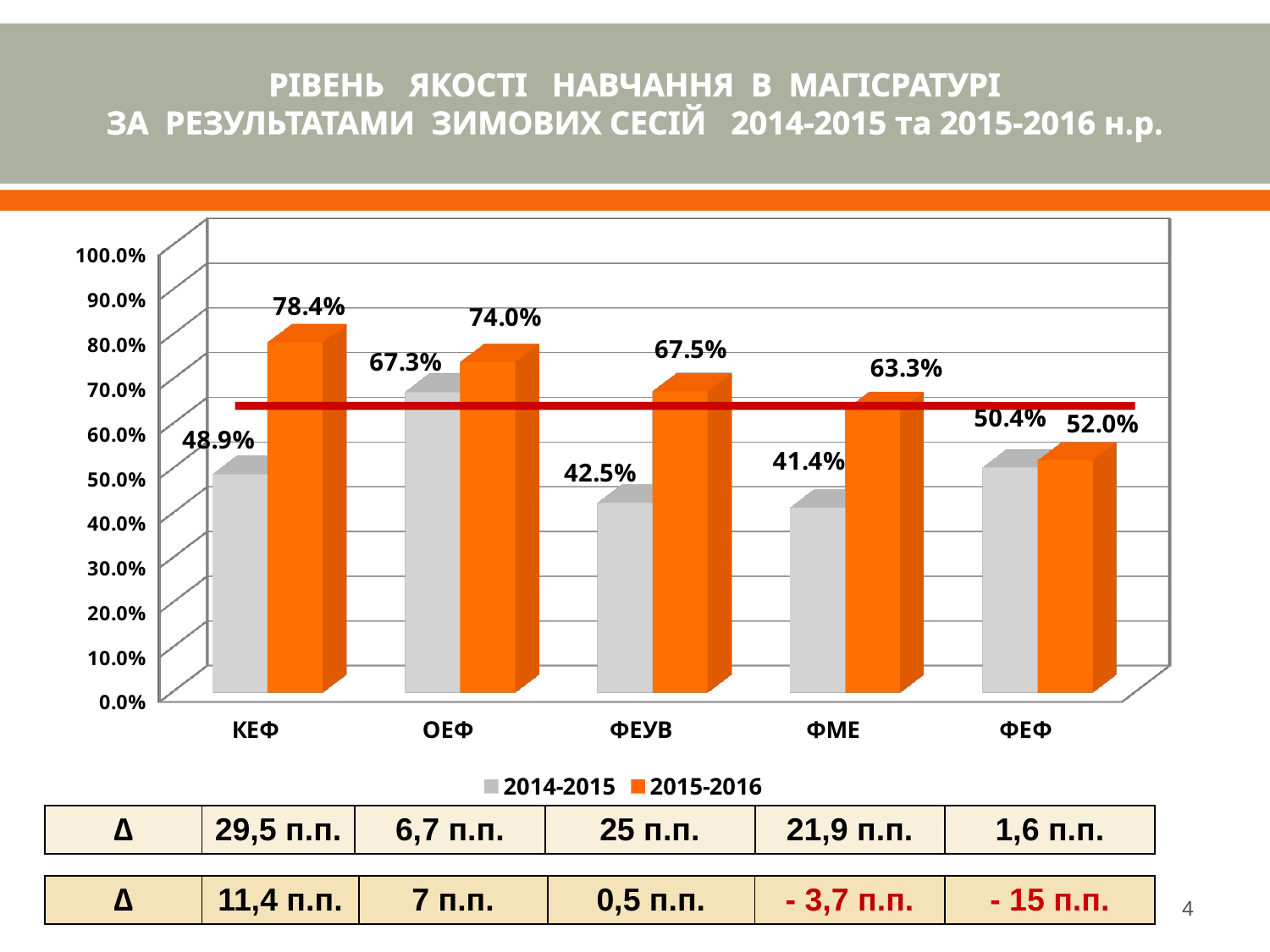
Which category has the lowest value in the 2014-2015 series? ФМЕ What is the value for ФМЕ in the 2014-2015 series? 41.4% Is the 2014-2015 value for ФЕУВ greater or less than 50.0%? less What is the value for КЕФ in the 2015-2016 series? 78.4% What kind of chart is shown on the slide? bar chart Which colour represents the 2015-2016 series in the legend? orange How many categories are shown on the x axis? 5 How many series does the legend list? 2 What is the difference between the 2015-2016 and 2014-2015 values for ФЕУВ? 25.0% What is the value for ФЕФ in the 2015-2016 series? 52.0% Which category has the highest value in the 2015-2016 series? КЕФ Which is larger for ОЕФ: the 2014-2015 value or the 2015-2016 value? 2015-2016